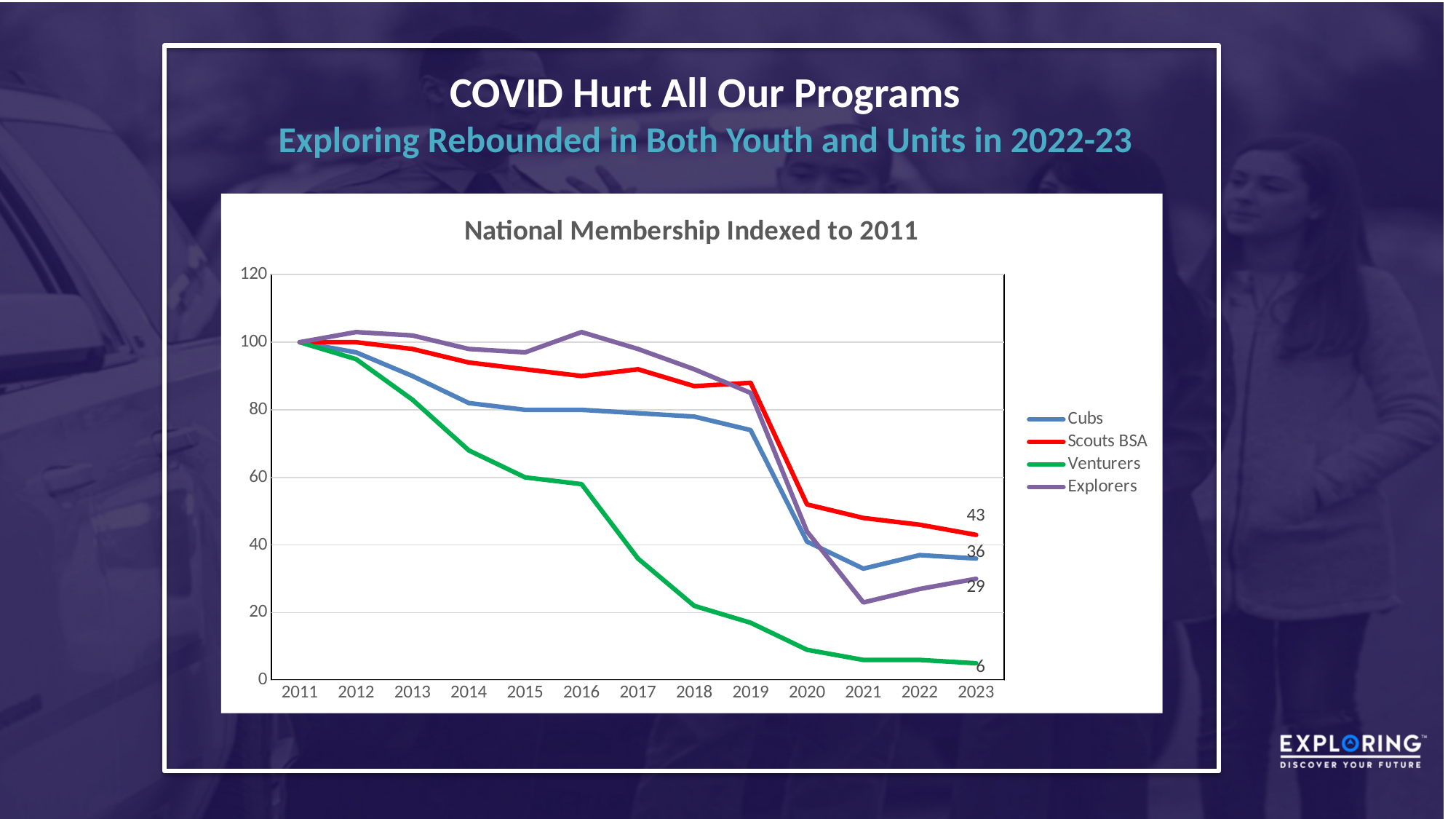
How many series does the legend list? 4 What is the indexed value for Explorers in 2023? 29 What is the indexed value for Scouts BSA in 2023? 43 Is the value for Venturers in 2018 greater or less than 40? less What is the indexed value for Cubs in 2023? 36 What is the difference between the 2023 values for Scouts BSA and Cubs? 7 How many years are shown on the x axis? 13 What kind of chart is shown on the slide? line chart Which series has the highest value in 2023? Scouts BSA Which series has the lowest value in 2023? Venturers What is the indexed value for Venturers in 2023? 6 What is the title of the chart? National Membership Indexed to 2011